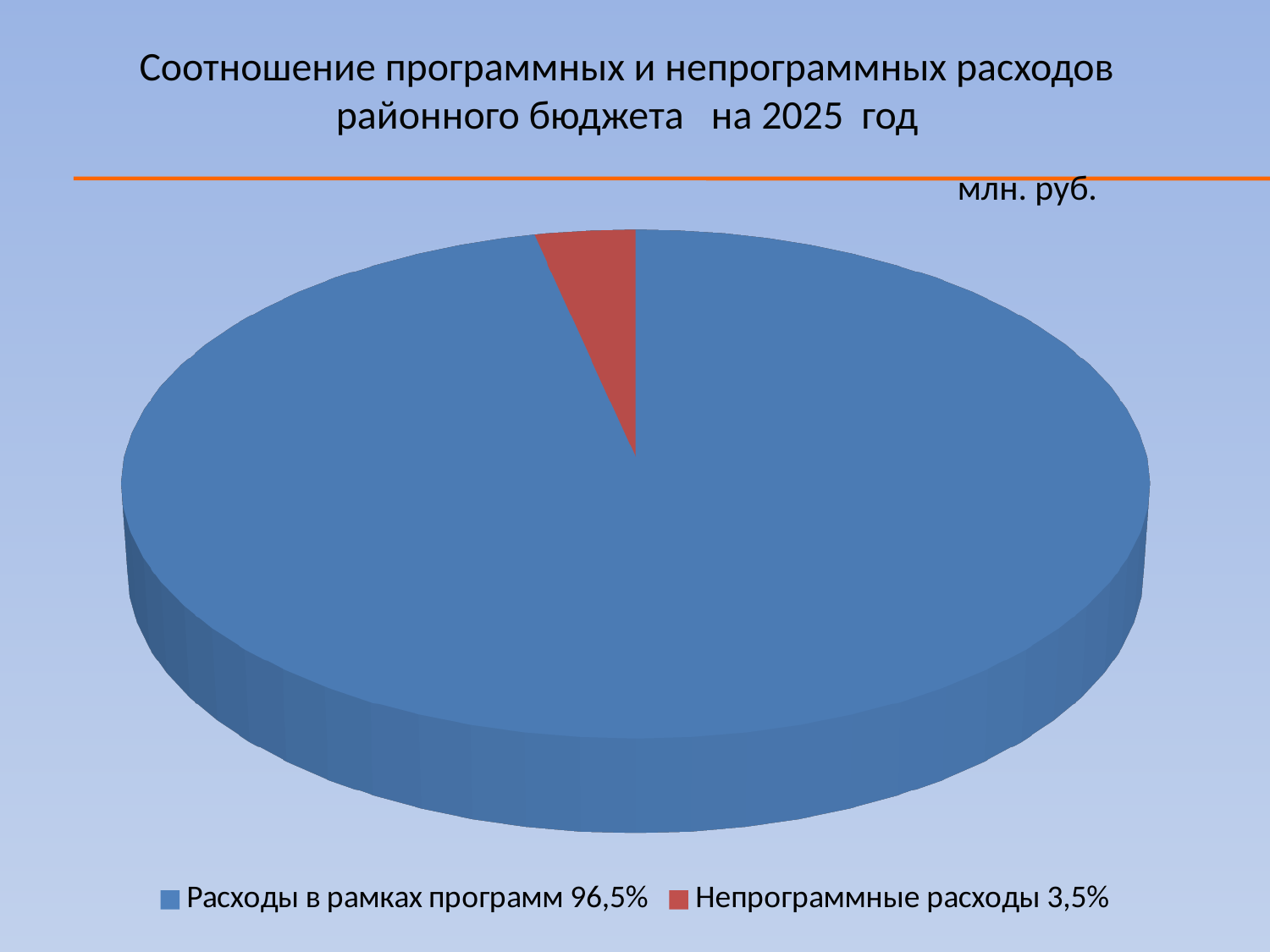
What share of the pie is 'Непрограммные расходы'? 3,5% How many slices does the pie chart have? 2 What share of the pie is 'Расходы в рамках программ'? 96,5% By how many percentage points does the share of 'Расходы в рамках программ' exceed that of 'Непрограммные расходы'? 93 How many entries does the legend list? 2 What kind of chart is shown on the slide? Pie chart What year does the chart title refer to? 2025 What colour is the slice for 'Непрограммные расходы'? Red Which category has the smallest share of the pie? Непрограммные расходы Which category has the largest share of the pie? Расходы в рамках программ Which is larger: the share of 'Расходы в рамках программ' or 'Непрограммные расходы'? Расходы в рамках программ